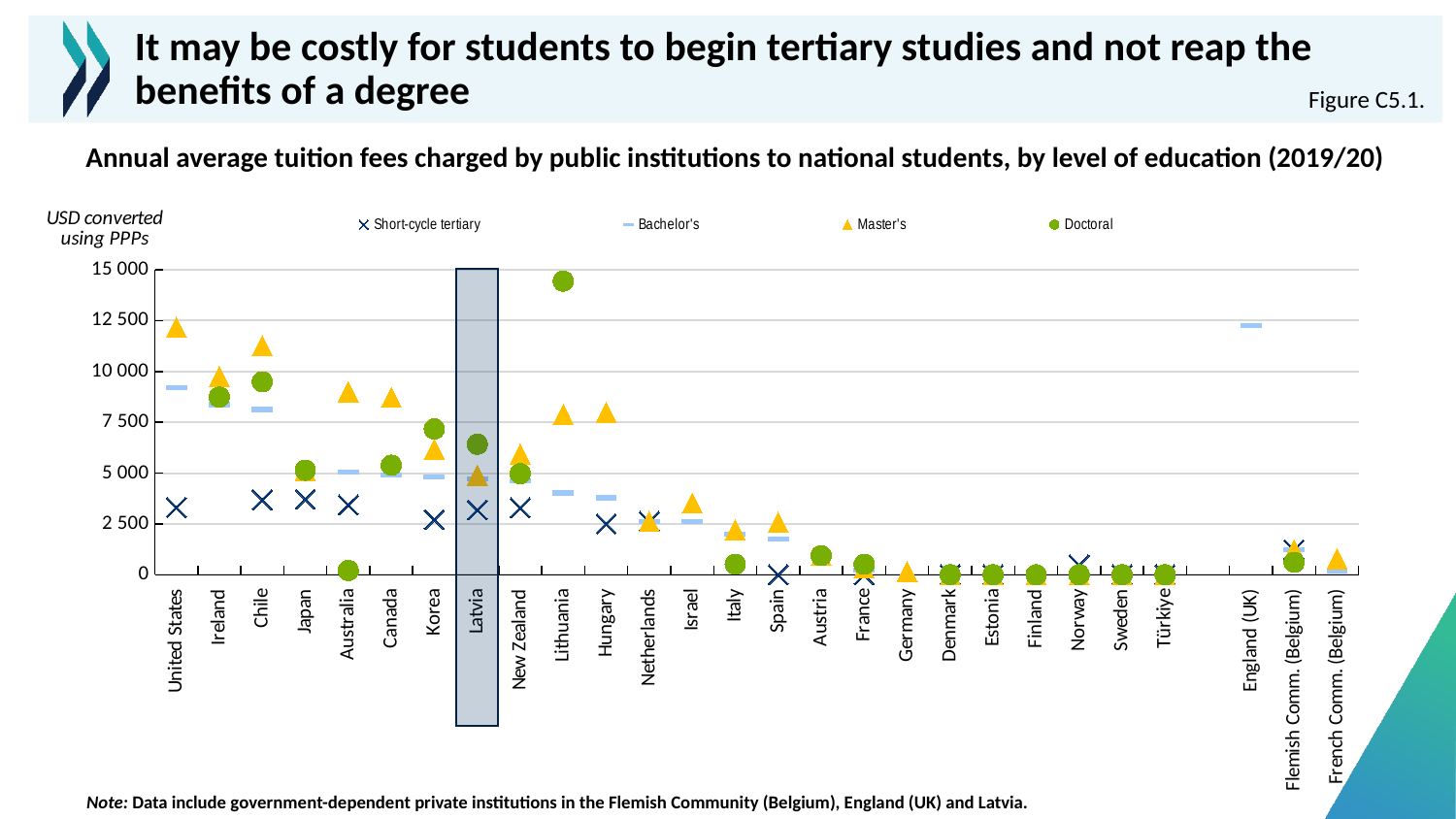
How many series does the legend list? 4 Which country has the highest Master's tuition fee? United States Which is larger, the Doctoral value for Lithuania or the Doctoral value for Latvia? Lithuania Which country is highlighted with a shaded box on the chart? Latvia How many countries or regions are shown on the x axis? 27 Which country has the highest Doctoral tuition fee? Lithuania Is the Doctoral value for Australia greater or less than 2 500? less What kind of chart is shown on the slide? Scatter chart Is the Master's value for the United States greater or less than 10 000? greater Which is larger, the Master's value for Chile or the Master's value for Japan? Chile Is the Doctoral value for Lithuania greater or less than 12 500? greater Which country has the highest Bachelor's tuition fee? England (UK)